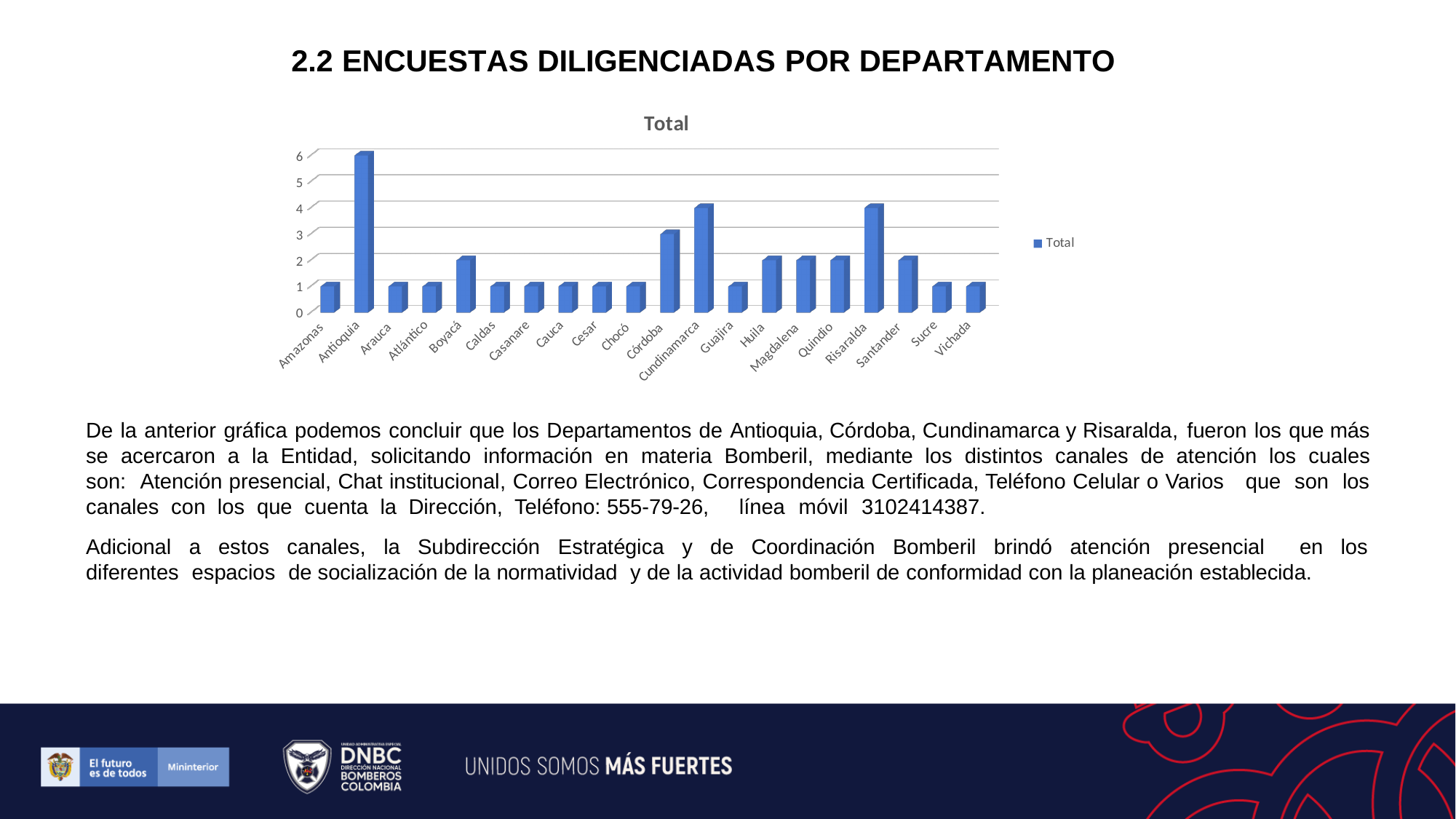
Which department has the highest value in the chart? Antioquia Is the value for Antioquia greater or less than 5? greater What is the value for Antioquia? 6 What is the title of the chart? Total What kind of chart is shown on the slide? bar chart What is the difference between the values for Antioquia and Risaralda? 2 How many series does the legend list? 1 How many departments are shown on the x axis of the chart? 20 What is the value for Córdoba? 3 What is the value for Boyacá? 2 Which is larger, the value for Córdoba or the value for Huila? Córdoba What is the value for Cundinamarca? 4